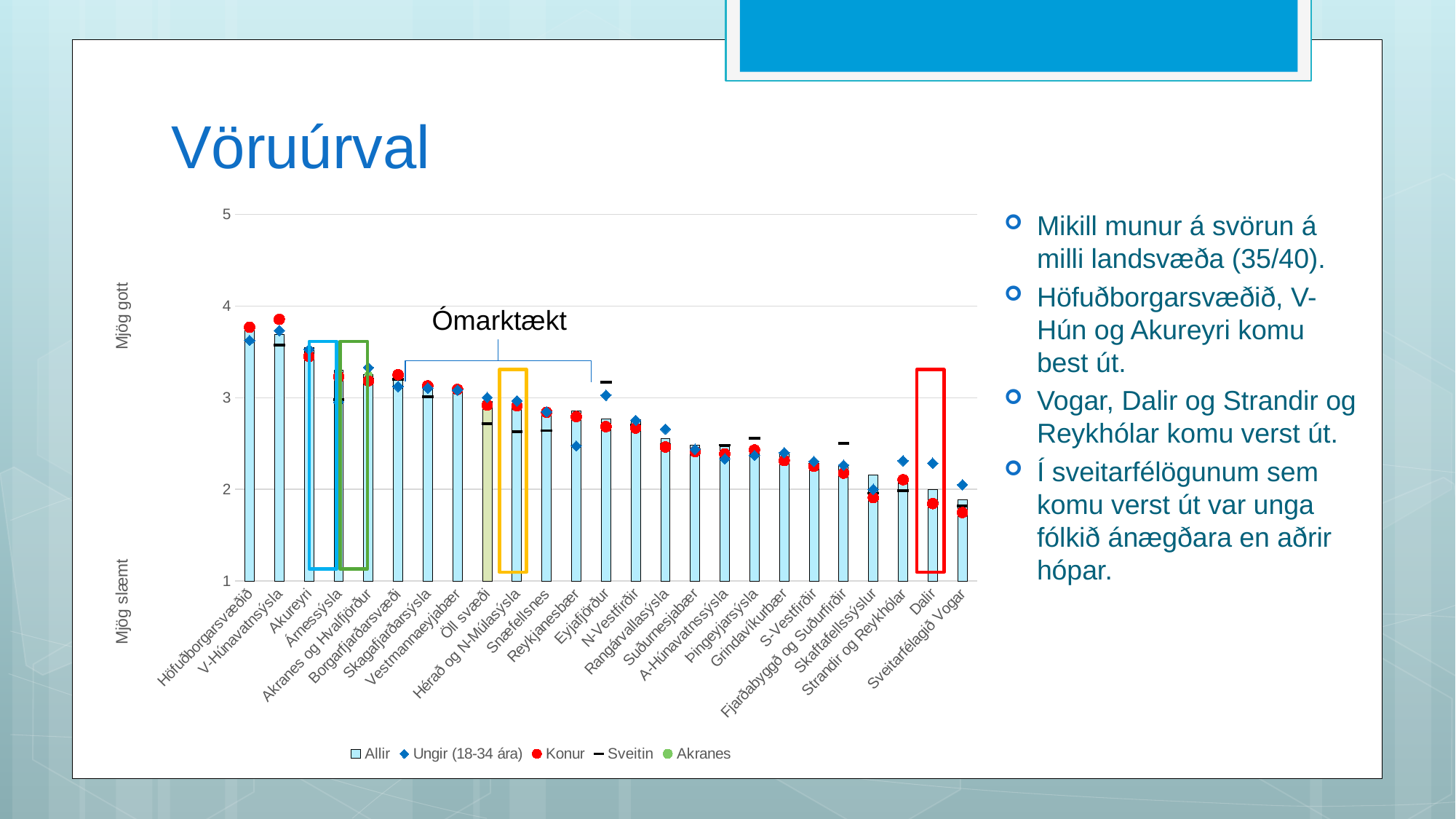
What kind of chart is shown on the slide? bar chart What annotation text is written above the bracketed group of bars in the middle of the chart? Ómarktækt How many categories are shown along the x axis of the chart? 25 What is the title of the chart on the slide? Vöruúrval Is the Allir value for Höfuðborgarsvæðið greater or less than 3? greater How many series does the chart legend list? 5 Do the Allir bars generally rise or fall from left to right along the x axis? fall Which has the higher Allir bar, Akureyri or Rangárvallasýsla? Akureyri Is the Allir value for Reykjanesbær greater or less than 3? less Which category has the lowest Allir bar? Sveitarfélagið Vogar Is the Allir value for Sveitarfélagið Vogar greater or less than 2? less